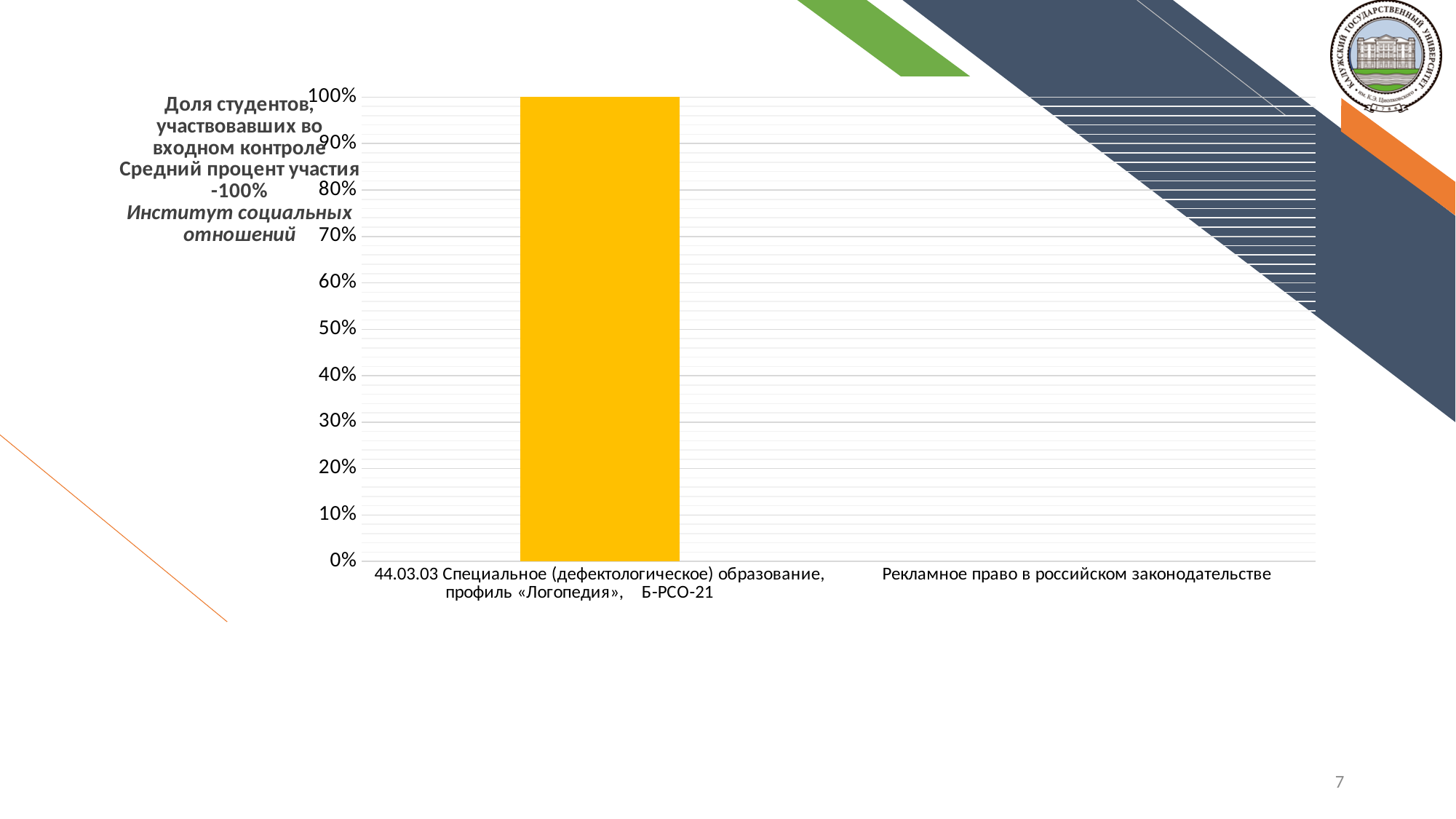
What is the second category label on the x axis of the chart? Рекламное право в российском законодательстве Which category has the highest bar in the chart? 44.03.03 Специальное (дефектологическое) образование, профиль «Логопедия», Б-РСО-21 Is the value for "44.03.03 Специальное (дефектологическое) образование, профиль «Логопедия», Б-РСО-21" greater or less than 50%? greater What is the value of the bar for "44.03.03 Специальное (дефектологическое) образование, профиль «Логопедия», Б-РСО-21"? 100% What is the highest value shown on the y axis of the chart? 100% What kind of chart is shown on the slide? bar chart How many categories are labelled on the x axis of the chart? 2 What colour is the bar in the chart? yellow